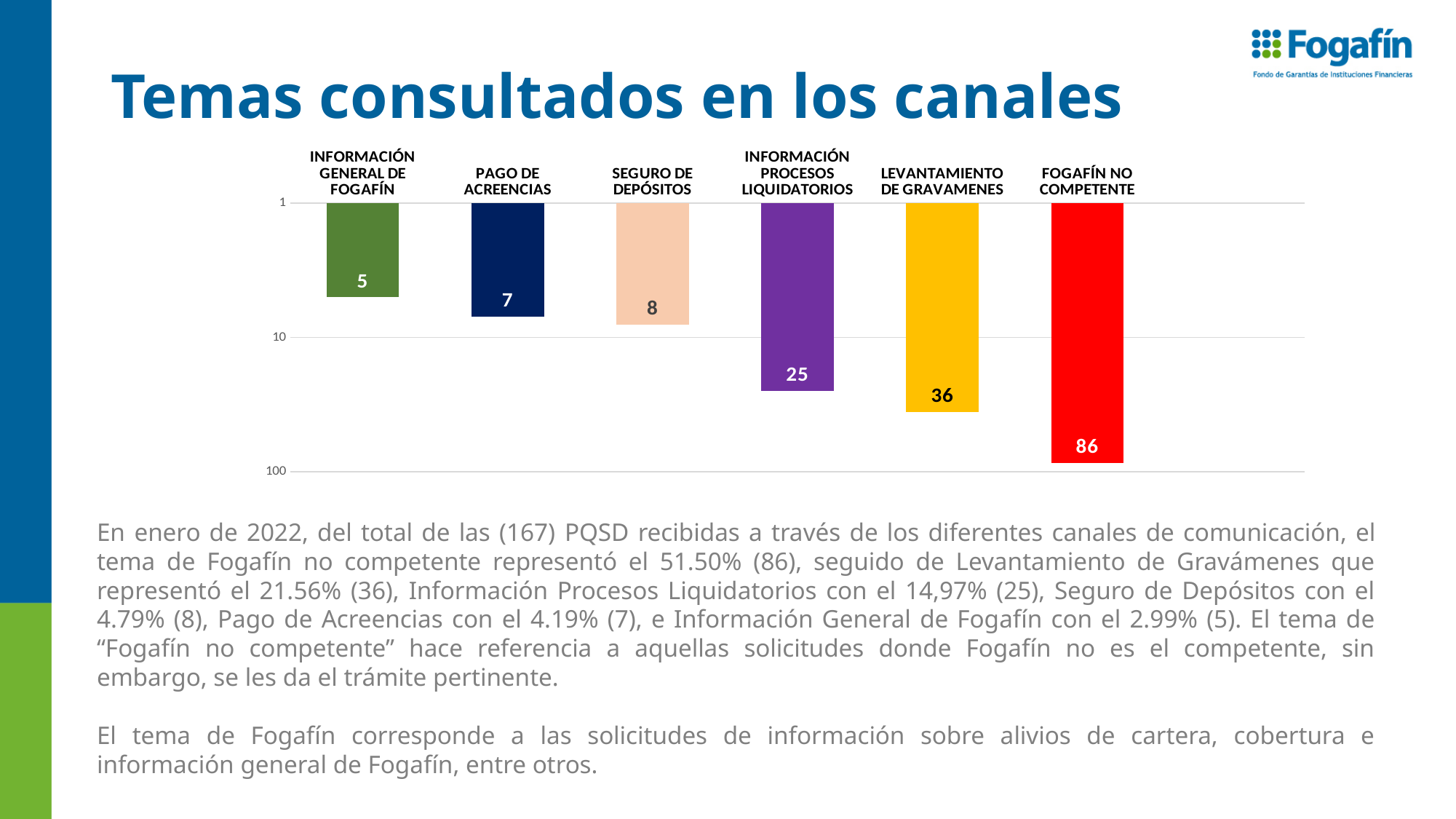
How many categories are shown in the chart? 6 What is the difference between the values for FOGAFÍN NO COMPETENTE and LEVANTAMIENTO DE GRAVAMENES? 50 What kind of chart is shown on the slide? Bar chart Do the values rise or fall from left to right across the categories? Rise Which is larger, the value for PAGO DE ACREENCIAS or the value for SEGURO DE DEPÓSITOS? SEGURO DE DEPÓSITOS What is the value for SEGURO DE DEPÓSITOS? 8 What is the value for INFORMACIÓN PROCESOS LIQUIDATORIOS? 25 What is the value for LEVANTAMIENTO DE GRAVAMENES? 36 Which category has the lowest value? INFORMACIÓN GENERAL DE FOGAFÍN What is the title of the slide containing the chart? Temas consultados en los canales What is the value for FOGAFÍN NO COMPETENTE? 86 Which category has the highest value? FOGAFÍN NO COMPETENTE